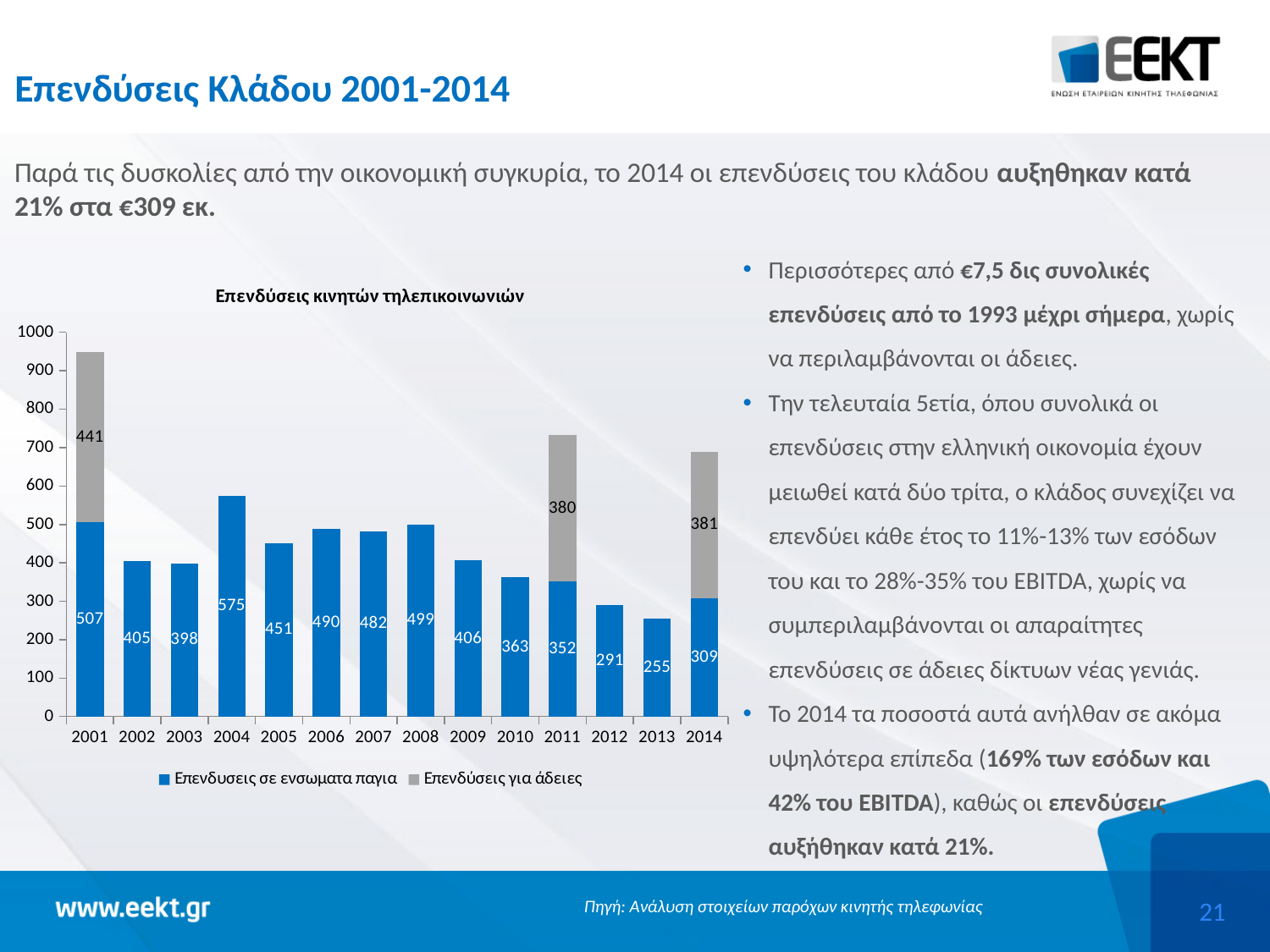
What type of chart is shown on the slide? Stacked bar chart Is the total stacked bar for 2001 greater or less than 900? greater What is the total of the stacked bar for 2014? 690 How many years are shown on the x axis of the chart? 14 What is the value of 'Επενδυσεις σε ενσωματα παγια' for 2004? 575 What is the value of 'Επενδύσεις για άδειες' for 2011? 380 What is the title of the chart? Επενδύσεις κινητών τηλεπικοινωνιών What is the difference between the 'Επενδυσεις σε ενσωματα παγια' values for 2014 and 2013? 54 Which year has the highest value for 'Επενδυσεις σε ενσωματα παγια'? 2004 Which is larger, the 'Επενδυσεις σε ενσωματα παγια' value for 2006 or for 2010? 2006 How many series does the chart legend list? 2 Which year has the lowest value for 'Επενδυσεις σε ενσωματα παγια'? 2013